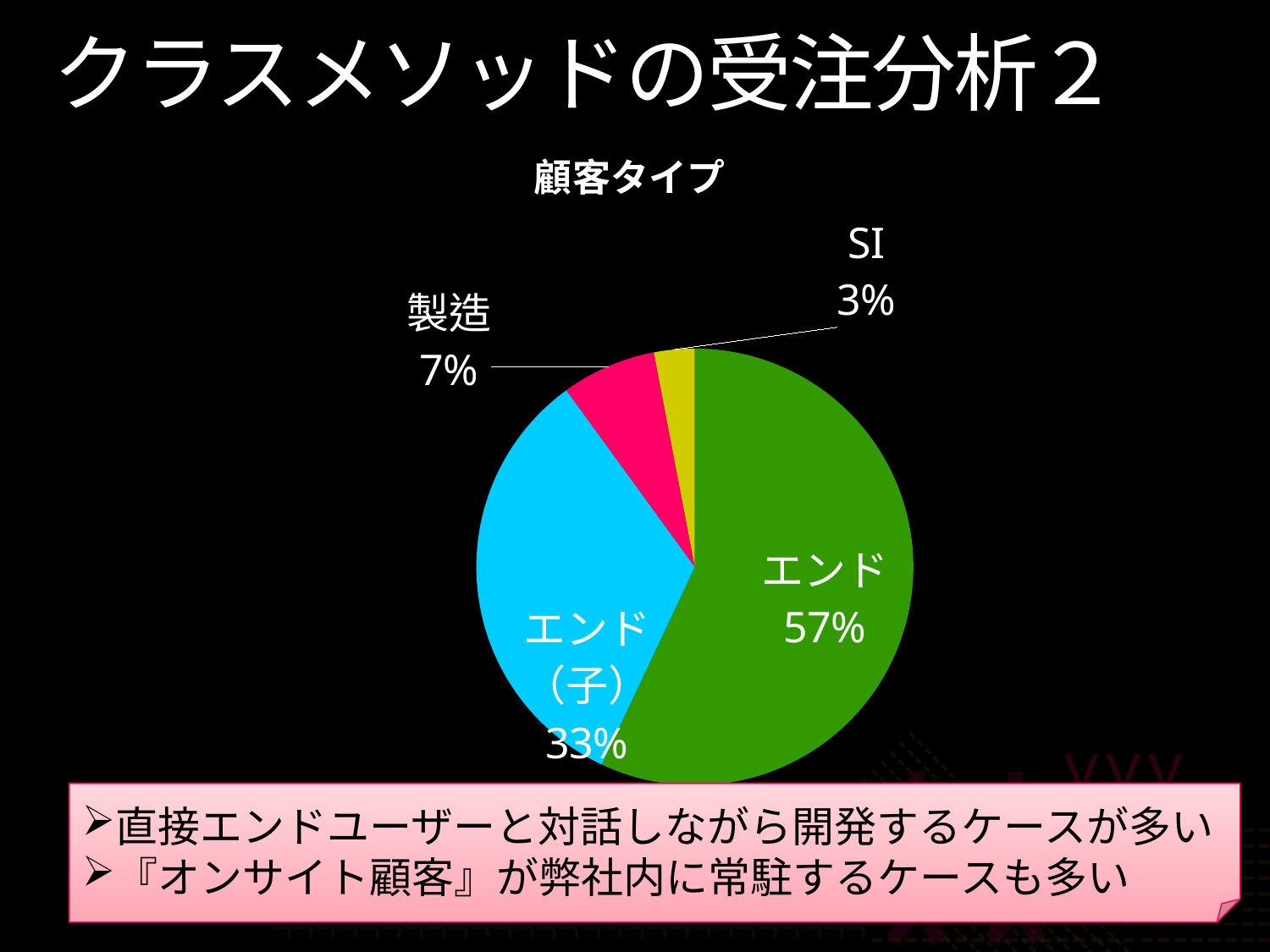
Which category has the smallest slice of the pie? SI Which category has the largest slice of the pie? エンド What share of the pie does SI have? 3% Which is larger, the share for 製造 or the share for SI? 製造 What kind of chart is shown on the slide? pie chart What is the title of the chart? 顧客タイプ What colour is the slice for エンド（子）? light blue What share of the pie does 製造 have? 7% How many slices does the pie chart have? 4 What share of the pie does エンド have? 57% What is the difference in percentage points between エンド and エンド（子）? 24 What share of the pie does エンド（子） have? 33%